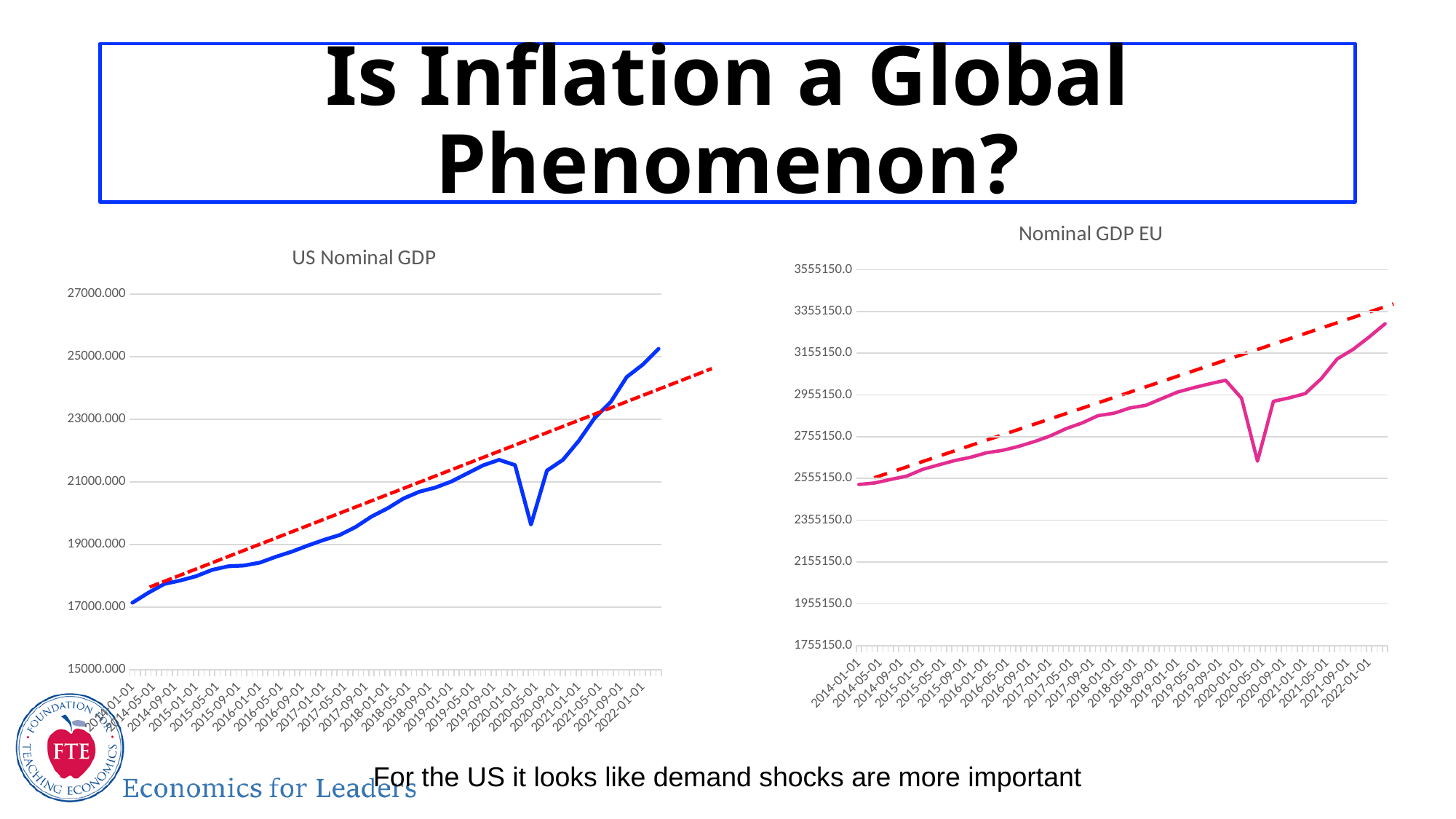
In the US Nominal GDP chart, is the value at 2014-01-01 greater or less than 19000.000? less In the Nominal GDP EU chart, is the value at 2014-01-01 greater or less than 2755150.0? less In the US Nominal GDP chart, is the value at 2022-01-01 greater or less than 23000.000? greater In the Nominal GDP EU chart, does the solid line generally rise or fall from 2014-01-01 to 2022-01-01? rise What kind of chart is the Nominal GDP EU chart? line chart What kind of chart is the US Nominal GDP chart? line chart In the US Nominal GDP chart, does the solid line generally rise or fall from 2014-01-01 to 2022-01-01? rise What colour is the solid data line in the US Nominal GDP chart? blue What is the title of the chart on the right side of the slide? Nominal GDP EU